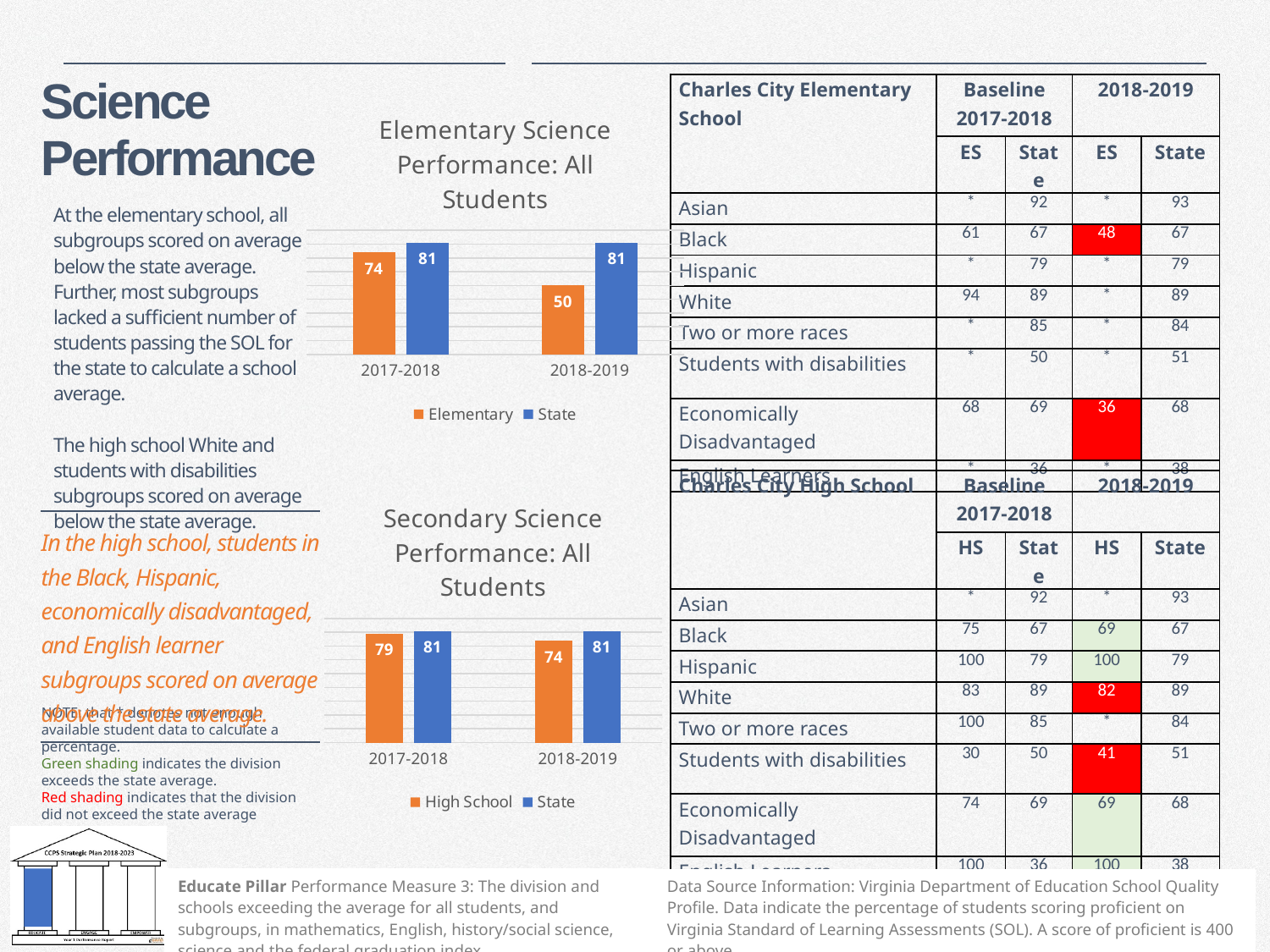
In the Elementary Science Performance: All Students chart, how many series does the legend list? 2 In the Secondary Science Performance: All Students chart, which is larger for 2017-2018, High School or State? State In the Elementary Science Performance: All Students chart, what is the State value for 2018-2019? 81 In the Elementary Science Performance: All Students chart, what is the Elementary value for 2018-2019? 50 In the Secondary Science Performance: All Students chart, what is the difference between the State and High School values for 2018-2019? 7 In the Elementary Science Performance: All Students chart, what is the Elementary value for 2017-2018? 74 In the Elementary Science Performance: All Students chart, what is the difference between the State and Elementary values for 2018-2019? 31 In the Secondary Science Performance: All Students chart, what is the High School value for 2018-2019? 74 What kind of chart is the Secondary Science Performance: All Students chart? bar chart In the Secondary Science Performance: All Students chart, what is the High School value for 2017-2018? 79 In the Secondary Science Performance: All Students chart, what colour are the High School bars? orange In the Elementary Science Performance: All Students chart, did the Elementary value rise or fall from 2017-2018 to 2018-2019? fall